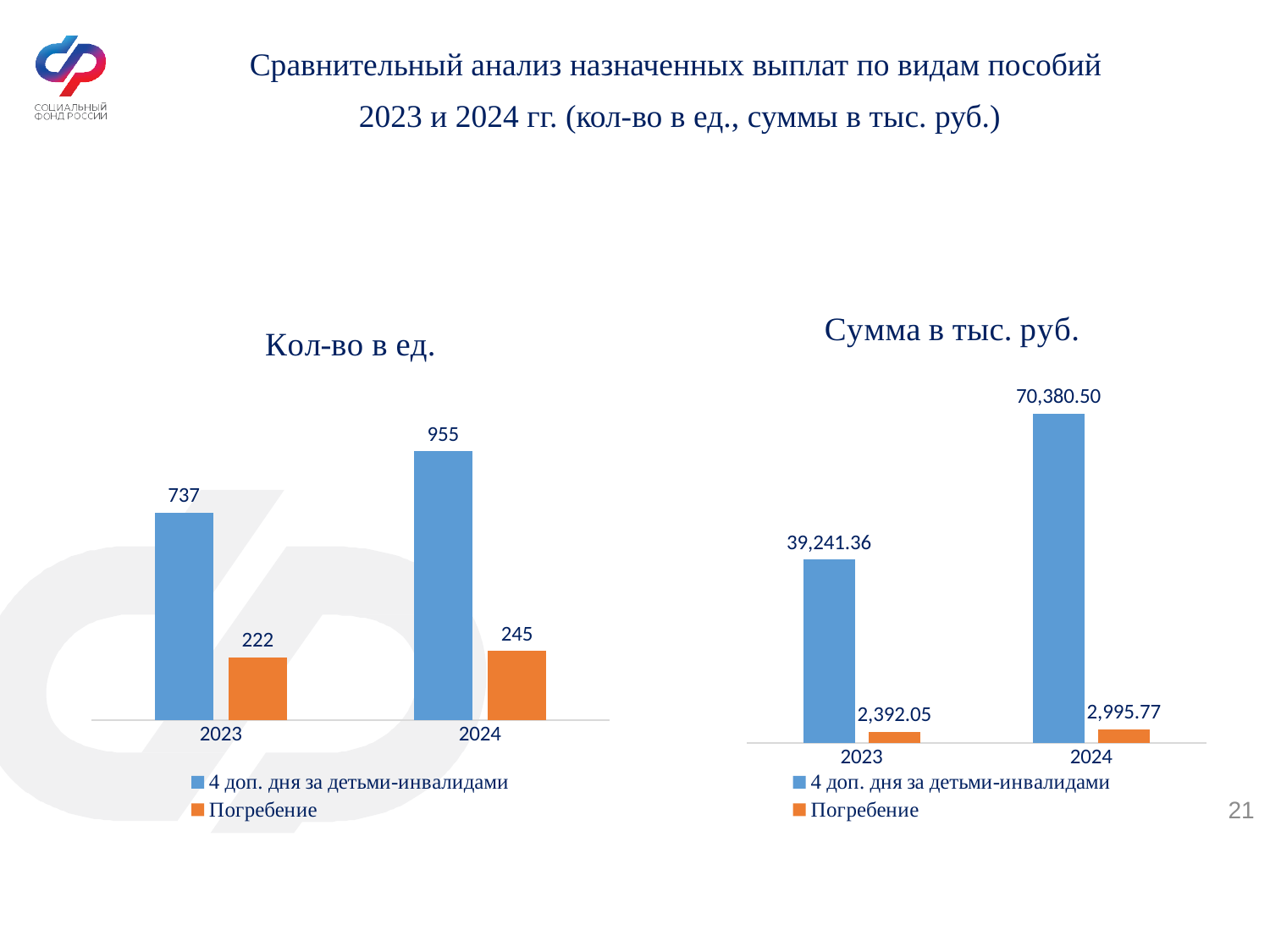
In the chart titled "Кол-во в ед.", what is the value for "4 доп. дня за детьми-инвалидами" in 2023? 737 In the chart titled "Сумма в тыс. руб.", which series has the highest value overall? 4 доп. дня за детьми-инвалидами In the chart titled "Сумма в тыс. руб.", what is the value for "4 доп. дня за детьми-инвалидами" in 2024? 70,380.50 In the chart titled "Сумма в тыс. руб.", what is the difference between the "Погребение" values for 2024 and 2023? 603.72 In the chart titled "Сумма в тыс. руб.", what is the value for "Погребение" in 2023? 2,392.05 How many series does the legend of the chart titled "Сумма в тыс. руб." list? 2 In the chart titled "Кол-во в ед.", by how much did the value for "4 доп. дня за детьми-инвалидами" change from 2023 to 2024? 218 In the chart titled "Кол-во в ед.", which year has the higher value for "Погребение"? 2024 What type of chart is the chart titled "Кол-во в ед."? Bar chart In the chart titled "Сумма в тыс. руб.", what is the difference between the "4 доп. дня за детьми-инвалидами" values for 2024 and 2023? 31,139.14 In the chart titled "Кол-во в ед.", what is the value for "Погребение" in 2024? 245 In the chart titled "Кол-во в ед.", which bar has the lowest value? Погребение in 2023